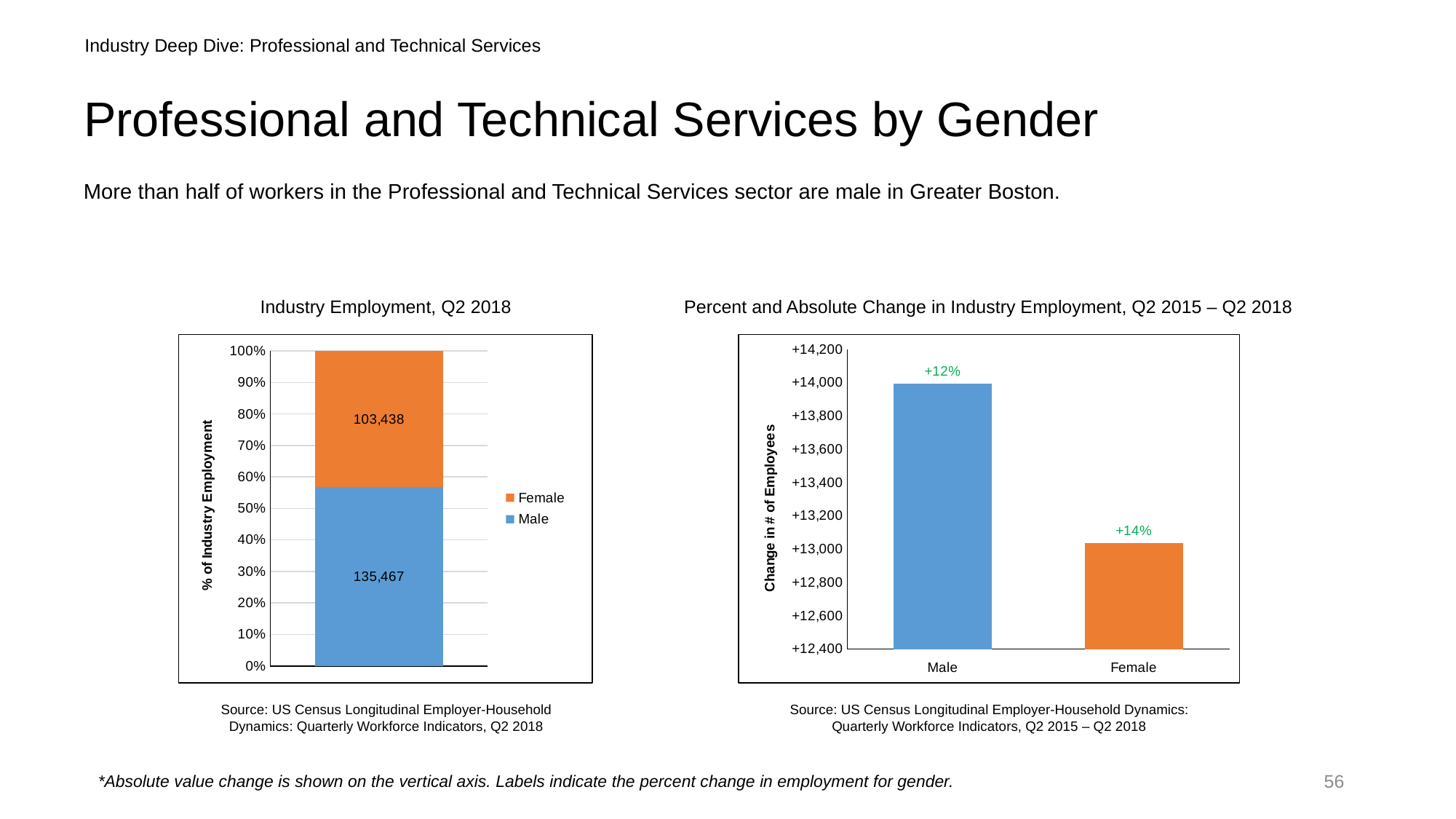
In the 'Industry Employment, Q2 2018' chart, what is the difference between the Male and Female values? 32,029 In the 'Percent and Absolute Change in Industry Employment, Q2 2015 – Q2 2018' chart, is the bar for Female greater or less than +13,200? less In the 'Industry Employment, Q2 2018' chart, which gender has the larger value? Male In the 'Industry Employment, Q2 2018' chart, what is the value shown for Female? 103,438 What kind of chart is the 'Percent and Absolute Change in Industry Employment, Q2 2015 – Q2 2018' chart? Bar chart In the 'Percent and Absolute Change in Industry Employment, Q2 2015 – Q2 2018' chart, what percent change label is shown for Male? +12% In the 'Industry Employment, Q2 2018' chart, what is the value shown for Male? 135,467 How many series does the legend of the 'Industry Employment, Q2 2018' chart list? 2 In the 'Industry Employment, Q2 2018' chart, which colour represents Female? Orange In the 'Percent and Absolute Change in Industry Employment, Q2 2015 – Q2 2018' chart, which category has the taller bar? Male In the 'Industry Employment, Q2 2018' chart, what is the total of the stacked bar (Male plus Female)? 238,905 In the 'Percent and Absolute Change in Industry Employment, Q2 2015 – Q2 2018' chart, what percent change label is shown for Female? +14%